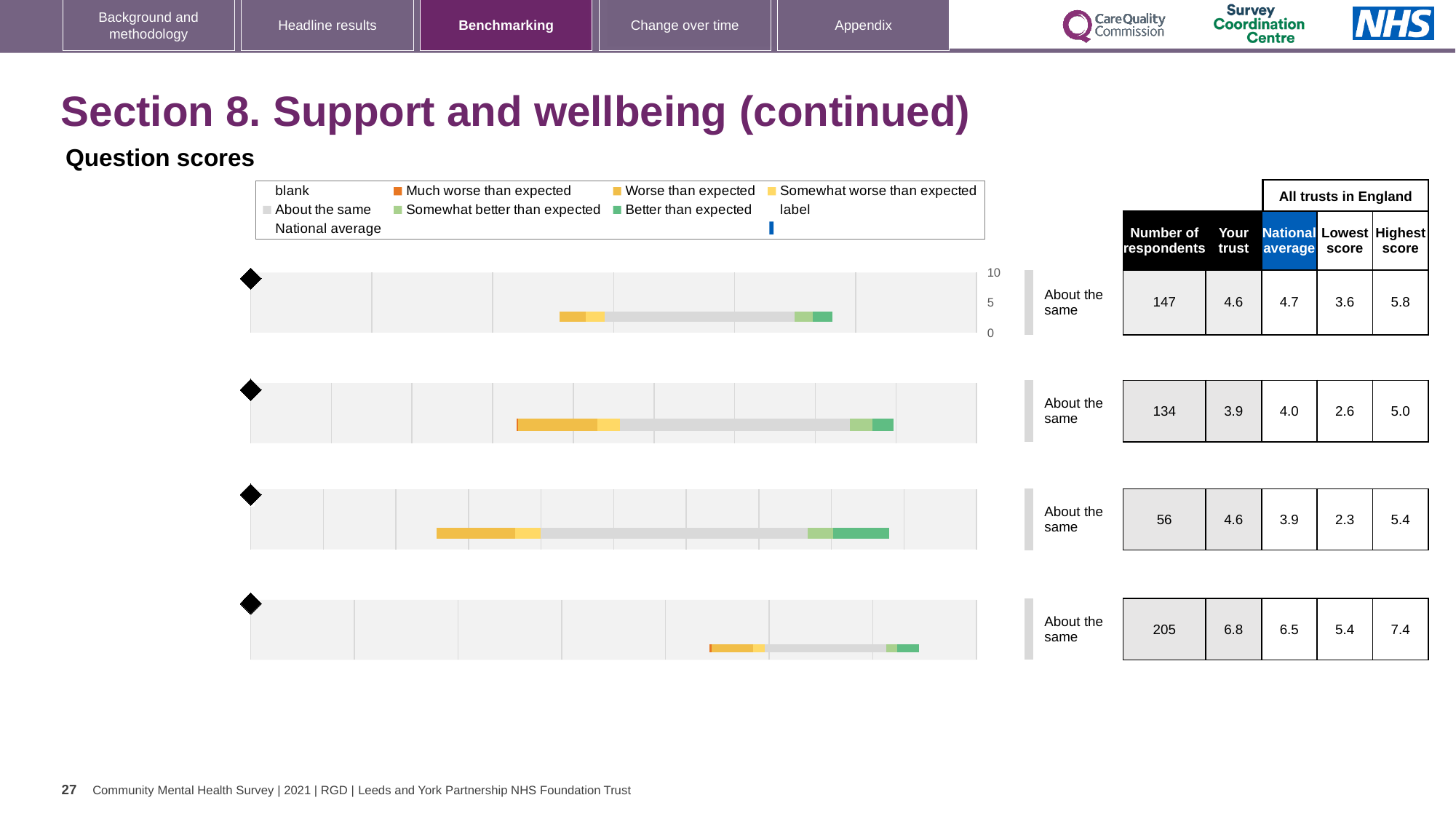
For the second chart, what is the national average score? 4.0 Which chart has the lowest number of respondents? the third chart How many question score charts are shown on the slide? 4 What is the maximum value shown on the score axis of the first chart? 10 For the second chart, what is the lowest score among all trusts in England? 2.6 Which chart has the highest 'Your trust' score? the fourth (bottom) chart For the first (top) chart, what is the 'Your trust' score? 4.6 For the fourth (bottom) chart, what is the difference between the highest score and the lowest score? 2.0 For the third chart, which is larger: the 'Your trust' score or the national average? Your trust For the first (top) chart, how many respondents are listed in the table? 147 What kind of chart is used to show the question scores on this slide? bar chart What benchmark category is shown next to each of the four charts? About the same